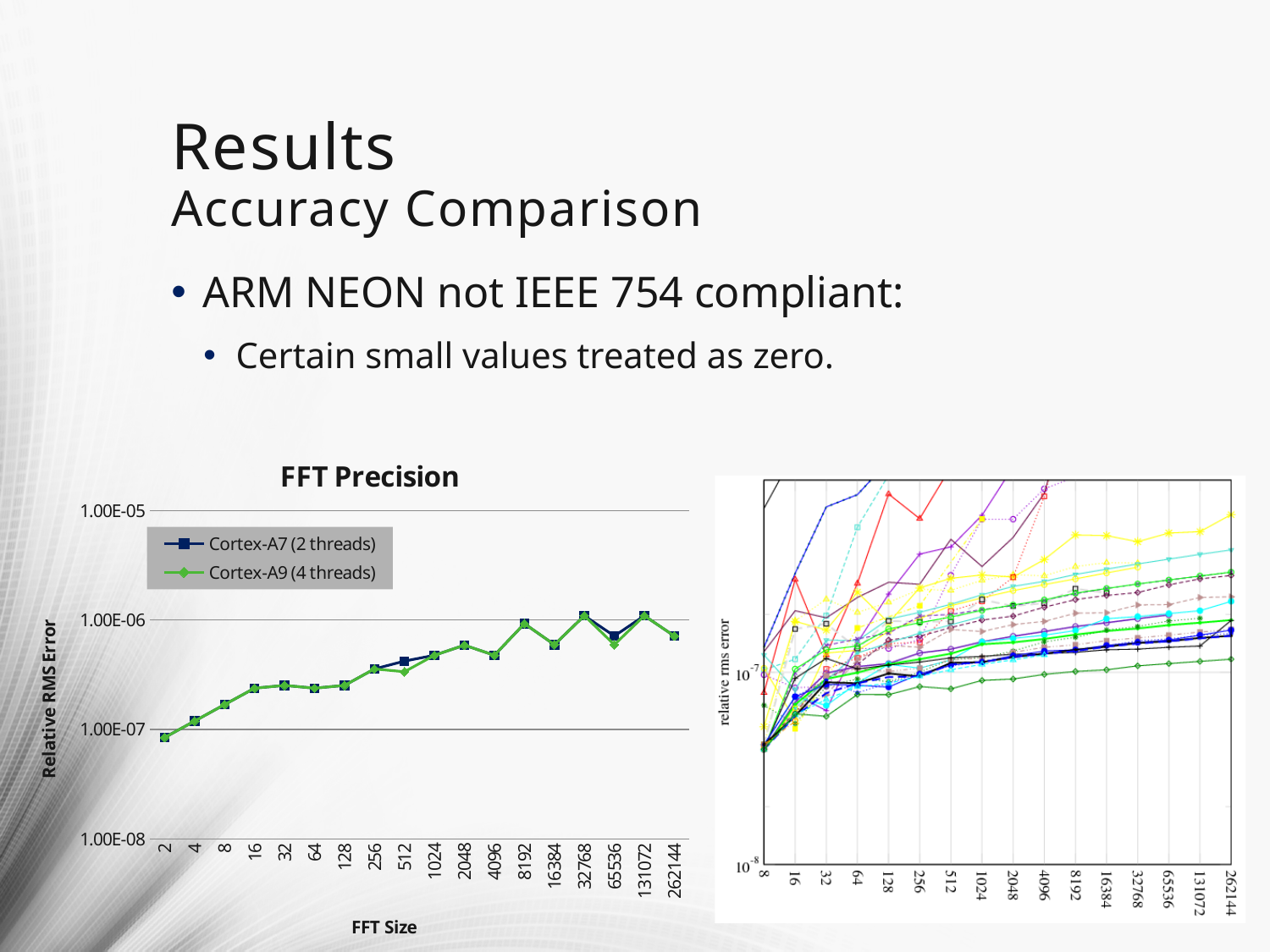
In the FFT Precision chart on the left, is the Cortex-A7 (2 threads) value at FFT size 256 greater or less than 1.00E-06? less In the FFT Precision chart on the left, what is the label of the x axis? FFT Size In the chart on the right, what is the smallest FFT size shown on the x axis? 8 In the chart on the right, how many FFT sizes are labelled on the x axis? 16 In the FFT Precision chart on the left, is the Cortex-A9 (4 threads) value at FFT size 65536 greater or less than 1.00E-06? less In the FFT Precision chart on the left, what kind of chart is it? line chart In the FFT Precision chart on the left, which series is drawn in green? Cortex-A9 (4 threads) In the FFT Precision chart on the left, is the Cortex-A9 (4 threads) value at FFT size 256 greater or less than 1.00E-07? greater In the FFT Precision chart on the left, do the relative RMS error values generally rise or fall as FFT size increases? rise In the FFT Precision chart on the left, how many FFT sizes are shown on the x axis? 18 In the FFT Precision chart on the left, how many series does the legend list? 2